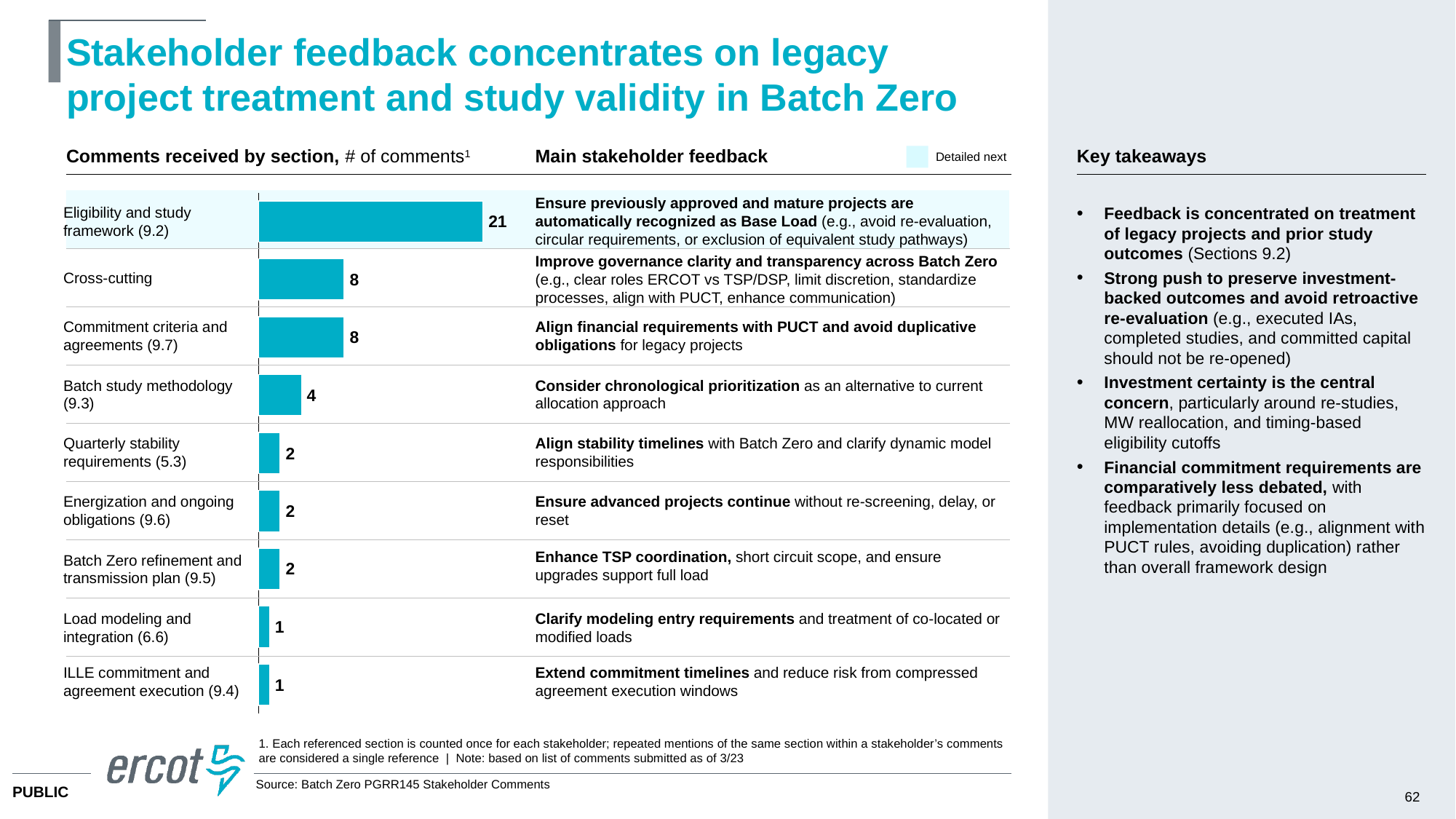
What type of chart is used to show comments received by section? Bar chart What is the difference in number of comments between Eligibility and study framework (9.2) and Cross-cutting? 13 Which received more comments: Batch study methodology (9.3) or Quarterly stability requirements (5.3)? Batch study methodology (9.3) Do the bar values rise or fall going down the chart from top to bottom? Fall How many comments were received for the Load modeling and integration (6.6) section? 1 What is the difference in number of comments between Commitment criteria and agreements (9.7) and Batch study methodology (9.3)? 4 Which section received the most comments? Eligibility and study framework (9.2) What does the light blue highlight in the chart indicate, according to the legend? Detailed next How many comments were received for the Batch study methodology (9.3) section? 4 How many comments were received for the Cross-cutting section? 8 How many comments were received for the Eligibility and study framework (9.2) section? 21 How many sections are shown in the Comments received by section chart? 9